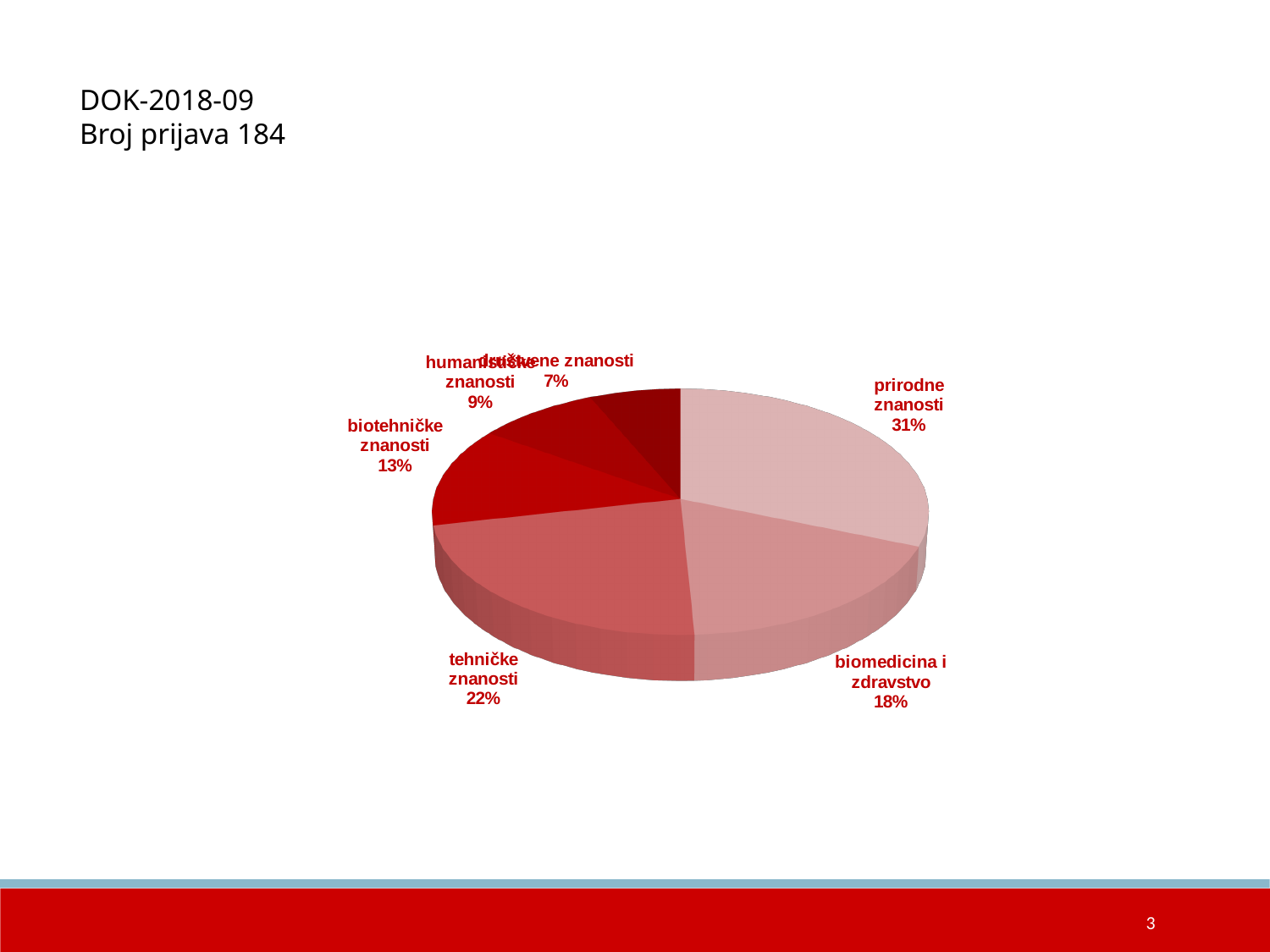
What total number of applications (Broj prijava) is stated on the slide? 184 What is the difference in percentage points between prirodne znanosti and tehničke znanosti? 9 Which category has the smallest slice of the pie? društvene znanosti What share of the pie does biotehničke znanosti have? 13% What kind of chart is shown on the slide? pie chart Which is larger, the share for biomedicina i zdravstvo or the share for biotehničke znanosti? biomedicina i zdravstvo Which category has the largest slice of the pie? prirodne znanosti What share of the pie does tehničke znanosti have? 22% What share of the pie does društvene znanosti have? 7% What share of the pie does prirodne znanosti have? 31% How many slices does the pie chart have? 6 What share of the pie does biomedicina i zdravstvo have? 18%